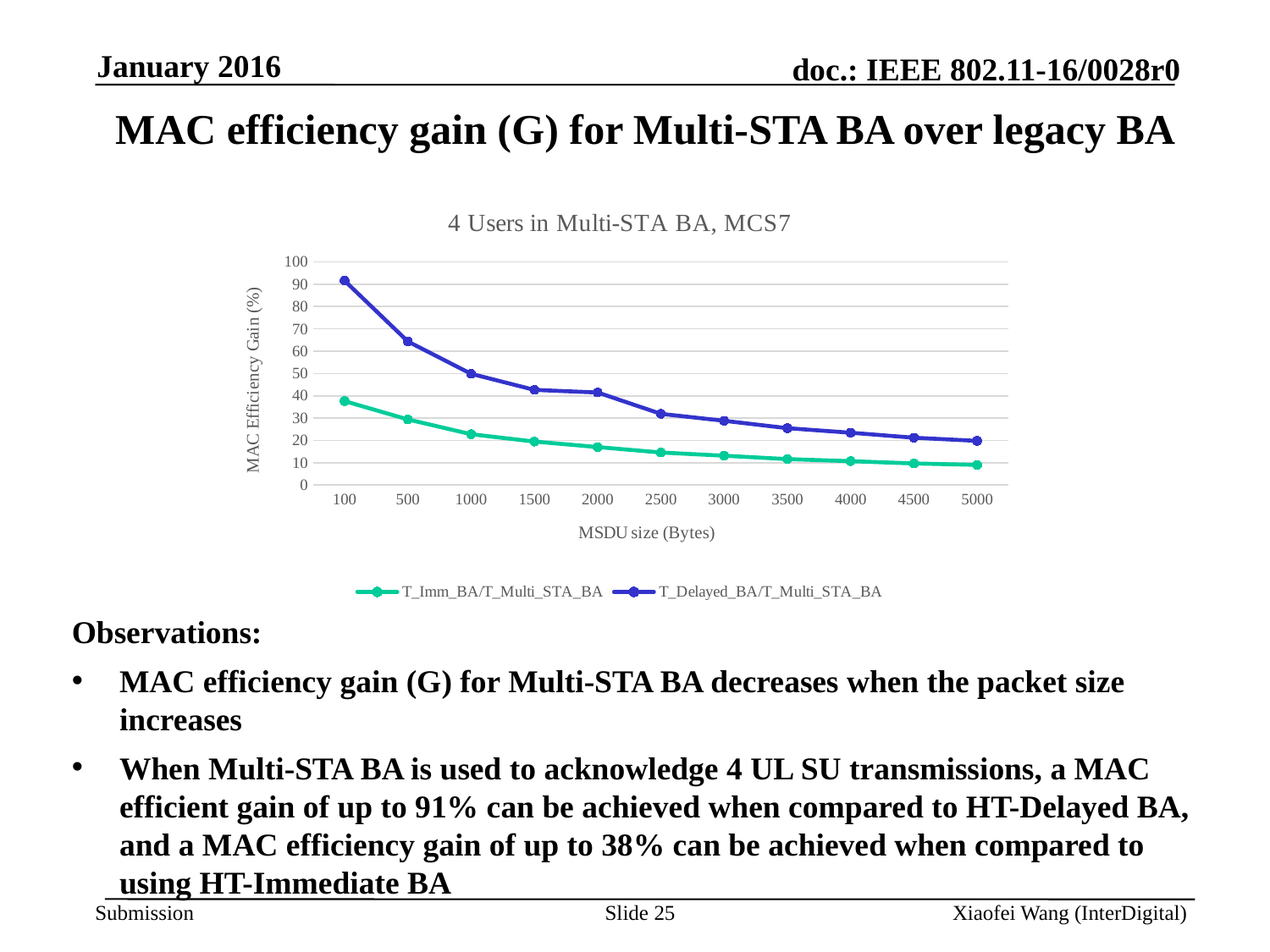
Do the values of the T_Delayed_BA/T_Multi_STA_BA series rise or fall as MSDU size increases? Fall How many MSDU size values are plotted along the x axis? 11 What kind of chart is shown on the slide? Line chart Is the value for T_Imm_BA/T_Multi_STA_BA at MSDU size 5000 greater or less than 20? less Is the value for T_Imm_BA/T_Multi_STA_BA at MSDU size 100 greater or less than 30? greater How many series does the chart legend list? 2 Is the value for T_Delayed_BA/T_Multi_STA_BA at MSDU size 100 greater or less than 80? greater What is the title of the chart? 4 Users in Multi-STA BA, MCS7 At which MSDU size does the T_Delayed_BA/T_Multi_STA_BA series reach its highest value? 100 At MSDU size 1000, which series has the higher MAC efficiency gain? T_Delayed_BA/T_Multi_STA_BA